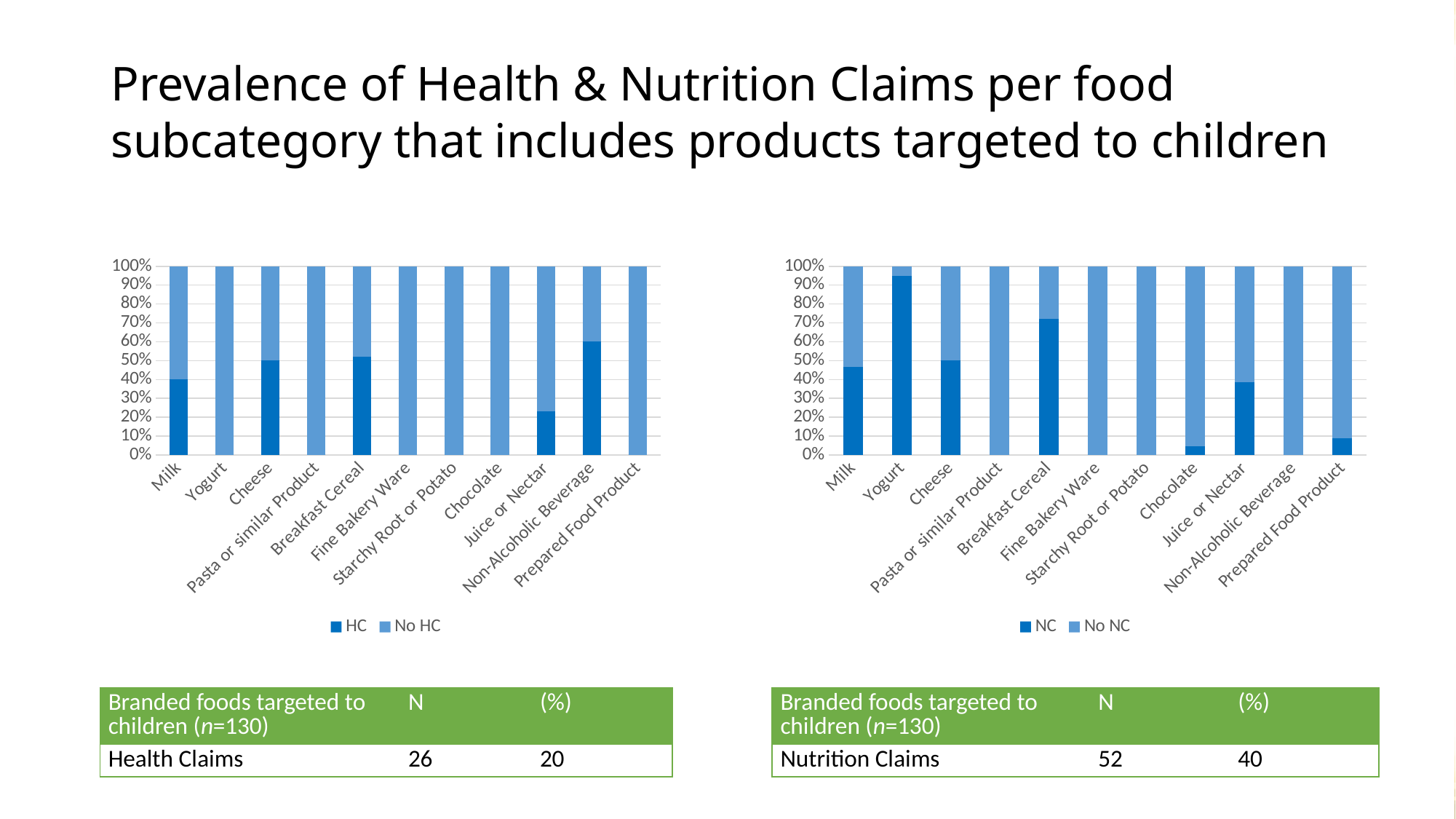
In the right chart (NC / No NC), is the NC share for Breakfast Cereal greater or less than 60%? greater What are the two legend entries of the right chart? NC and No NC In the left chart (HC / No HC), which has a larger HC share: Milk or Non-Alcoholic Beverage? Non-Alcoholic Beverage In the left chart (HC / No HC), which food subcategory has the highest HC share? Non-Alcoholic Beverage In the left chart (HC / No HC), is the HC share for Yogurt greater or less than 10%? less In the right chart (NC / No NC), which food subcategory has the highest NC share? Yogurt In the left chart (HC / No HC), is the HC share for Juice or Nectar greater or less than 30%? less In the right chart (NC / No NC), which has a larger NC share: Chocolate or Juice or Nectar? Juice or Nectar How many food subcategories are shown on the x axis of the right chart (NC / No NC)? 11 How many series does the legend of the left chart (HC / No HC) list? 2 What kind of chart is the left chart (HC / No HC)? Stacked bar chart